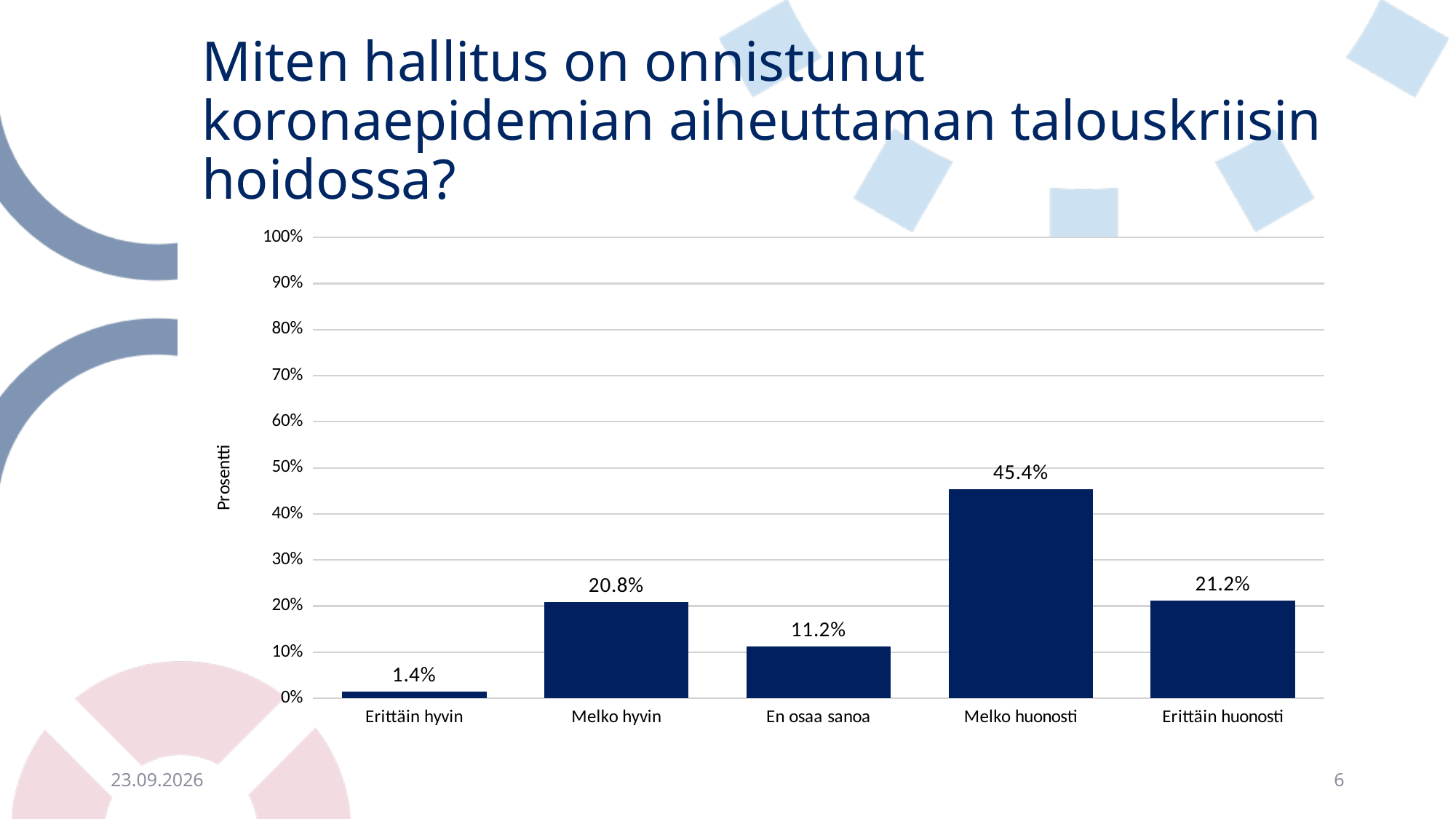
What is the difference between the values for Melko huonosti and Erittäin huonosti? 24.2% What is the value for Melko huonosti? 45.4% How many categories are shown on the x axis? 5 What is the value for En osaa sanoa? 11.2% What is the label of the vertical axis? Prosentti Which category has the lowest value? Erittäin hyvin What is the value for Erittäin huonosti? 21.2% Which category has the highest value? Melko huonosti What is the value for Erittäin hyvin? 1.4% What kind of chart is shown on the slide? bar chart Which is larger, the value for Melko hyvin or the value for En osaa sanoa? Melko hyvin Is the value for Melko huonosti greater or less than 40%? greater